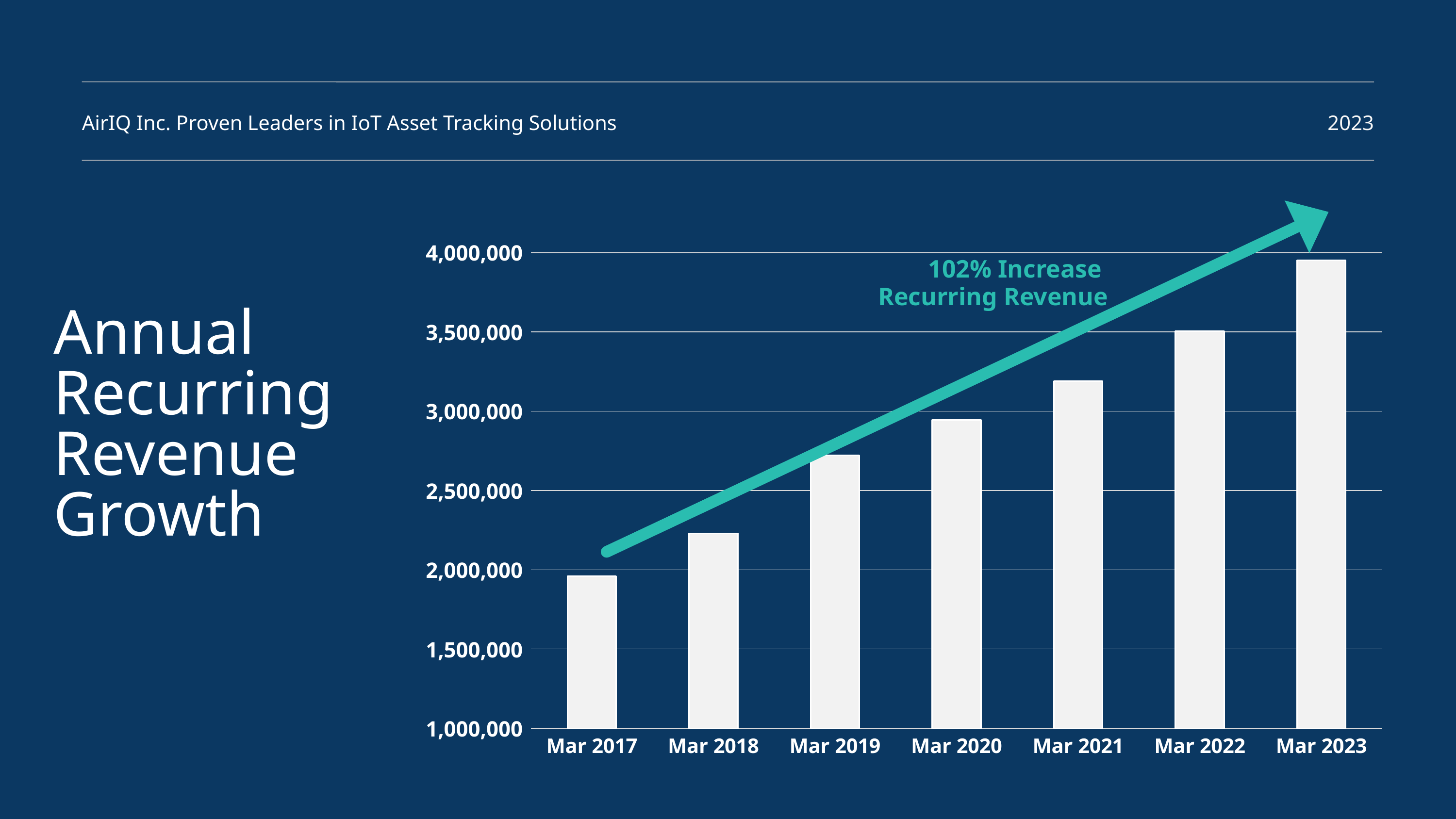
What kind of chart is shown on the slide? Bar chart Do the values rise or fall from Mar 2017 to Mar 2023? Rise Which year has the highest annual recurring revenue? Mar 2023 What percentage increase in recurring revenue is annotated on the chart? 102% Is the value for Mar 2023 greater or less than 3,500,000? greater Which year has the lowest annual recurring revenue? Mar 2017 Is the value for Mar 2021 greater or less than 3,500,000? less Which is larger, the value for Mar 2021 or the value for Mar 2019? Mar 2021 What is the title of the slide containing the chart? Annual Recurring Revenue Growth Is the value for Mar 2018 greater or less than 2,000,000? greater How many bars (years) are plotted in the chart? 7